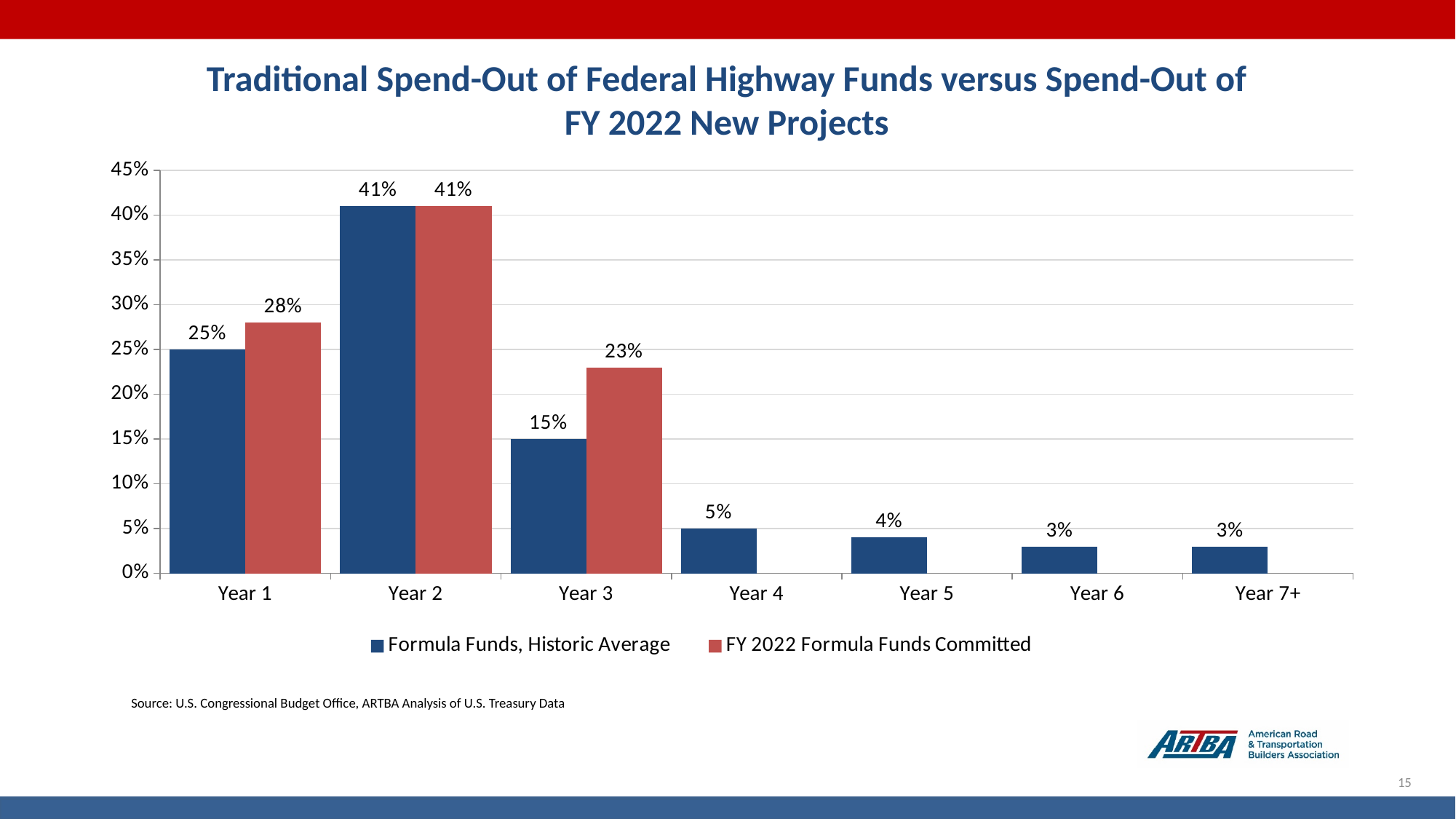
Which year has the lowest value for FY 2022 Formula Funds Committed among the years where it is plotted? Year 3 What is the difference between FY 2022 Formula Funds Committed and Formula Funds, Historic Average in Year 3? 8% Does the Formula Funds, Historic Average series rise or fall from Year 2 to Year 7+? Fall What kind of chart is shown on the slide? Bar chart Is the value for Formula Funds, Historic Average in Year 4 greater or less than 10%? less What is the value for Formula Funds, Historic Average in Year 7+? 3% What is the value for Formula Funds, Historic Average in Year 1? 25% What is the value for FY 2022 Formula Funds Committed in Year 3? 23% How many year categories are shown on the x axis? 7 Which year has the highest value for Formula Funds, Historic Average? Year 2 In Year 1, which series has the larger value: Formula Funds, Historic Average or FY 2022 Formula Funds Committed? FY 2022 Formula Funds Committed How many series does the legend list? 2